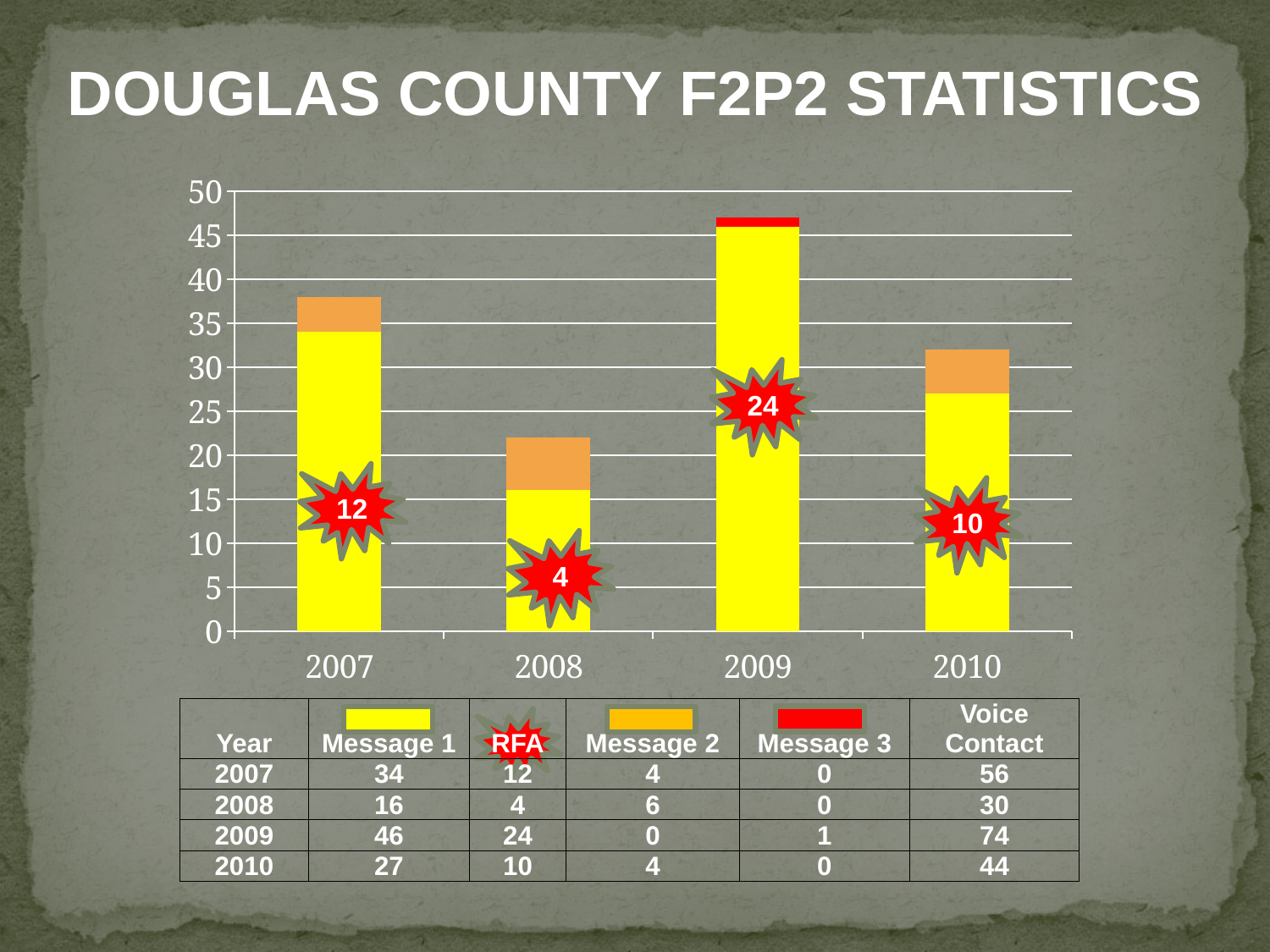
What RFA value is shown in the starburst label on the 2009 bar? 24 Which year has the lowest Message 1 value? 2008 What is the total of the stacked bar for 2007 (Message 1 + Message 2 + Message 3)? 38 Which year has the highest Message 1 value? 2009 What is the Message 2 value for 2008? 6 What is the Message 1 value for 2009? 46 How many years are shown on the x axis of the chart? 4 What is the difference between the Message 1 values for 2009 and 2008? 30 Which colour represents Message 3 in the chart? red Is the total height of the 2009 stacked bar greater or less than 45? greater Which is larger, the Message 1 value for 2007 or for 2010? 2007 What kind of chart is shown on the slide? stacked bar chart